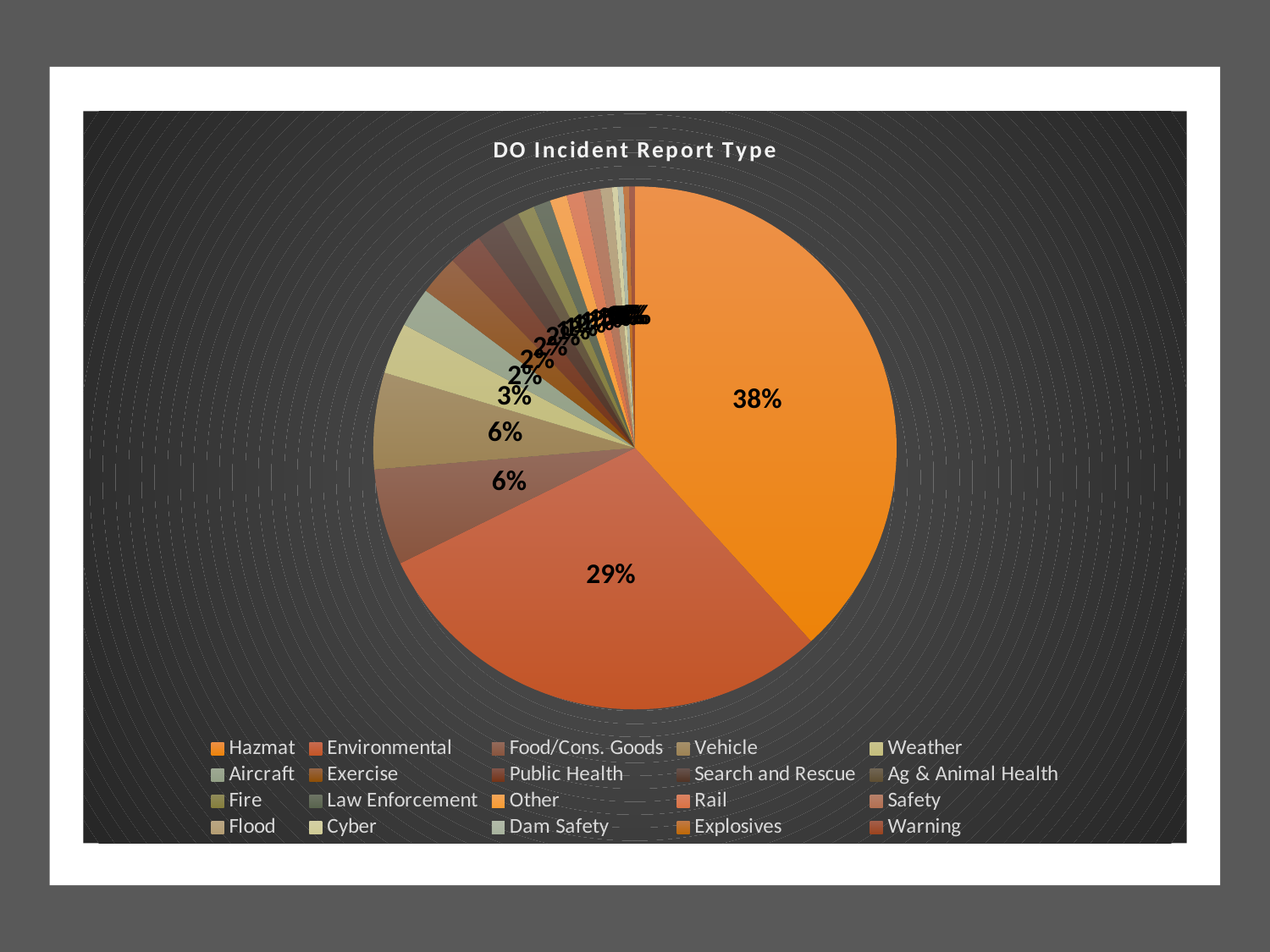
What percentage of the pie is Environmental? 29% What percentage of the pie is Hazmat? 38% What is the title of the chart? DO Incident Report Type What percentage of the pie is Food/Cons. Goods? 6% What do the Hazmat and Environmental slices add up to? 67% What kind of chart is shown on the slide? Pie chart What is the difference in percentage points between the Hazmat and Environmental slices? 9 percentage points What percentage of the pie is Vehicle? 6% Which slice is larger, Hazmat or Environmental? Hazmat How many categories does the legend list? 20 What percentage of the pie is Weather? 3% Which incident report type has the largest share of the pie? Hazmat